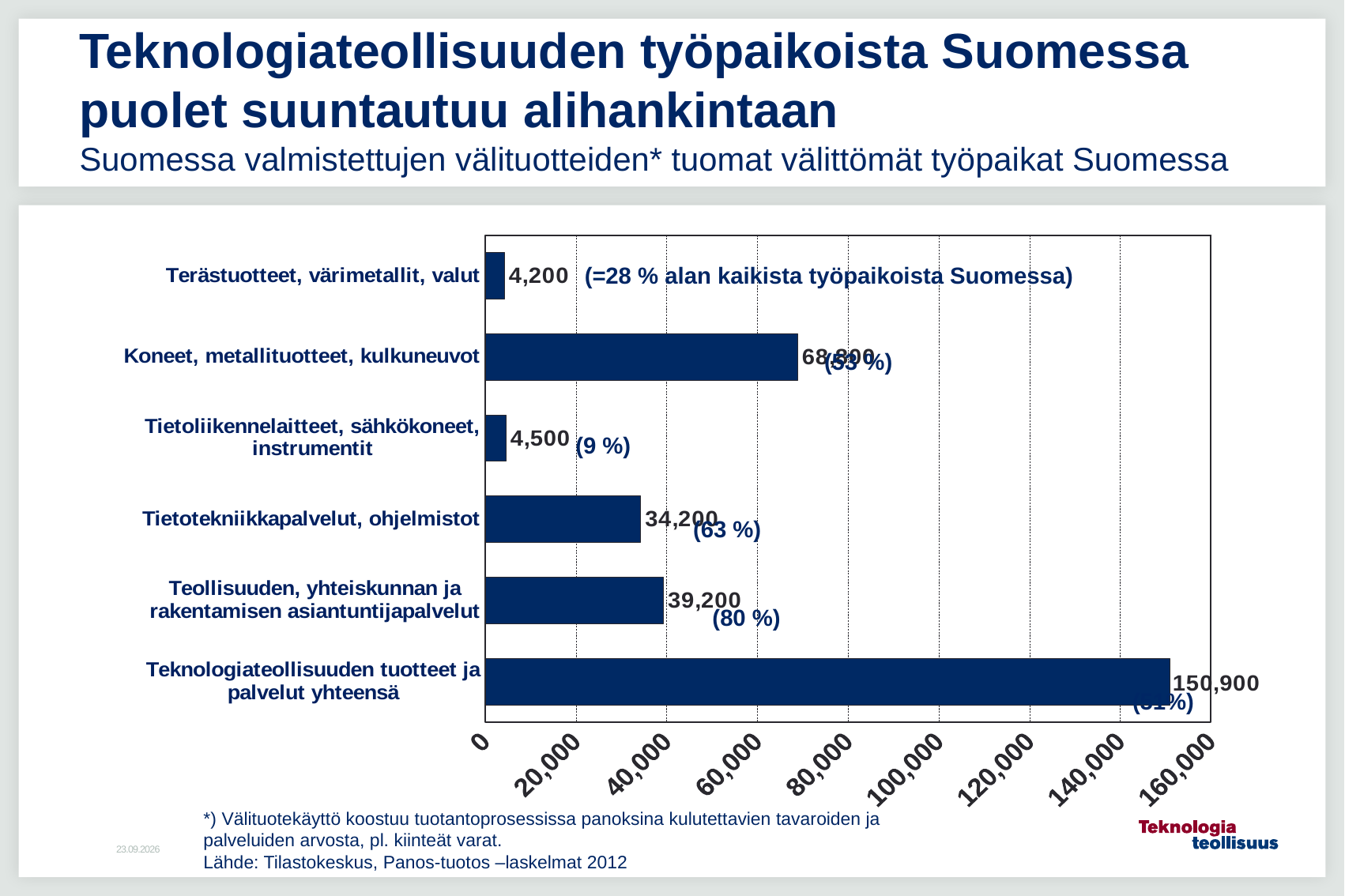
What is the value for Teknologiateollisuuden tuotteet ja palvelut yhteensä? 150,900 What is the difference between the values for Teollisuuden, yhteiskunnan ja rakentamisen asiantuntijapalvelut and Tietotekniikkapalvelut, ohjelmistot? 5,000 Is the value for Koneet, metallituotteet, kulkuneuvot greater or less than 60,000? greater What kind of chart is shown on the slide? bar chart Which category has the lowest value? Terästuotteet, värimetallit, valut What is the value for Tietotekniikkapalvelut, ohjelmistot? 34,200 What is the value for Terästuotteet, värimetallit, valut? 4,200 What is the value for Tietoliikennelaitteet, sähkökoneet, instrumentit? 4,500 How many categories are shown in the chart? 6 Which category has the highest value? Teknologiateollisuuden tuotteet ja palvelut yhteensä What is the value for Teollisuuden, yhteiskunnan ja rakentamisen asiantuntijapalvelut? 39,200 Which is larger: the value for Tietotekniikkapalvelut, ohjelmistot or the value for Teollisuuden, yhteiskunnan ja rakentamisen asiantuntijapalvelut? Teollisuuden, yhteiskunnan ja rakentamisen asiantuntijapalvelut